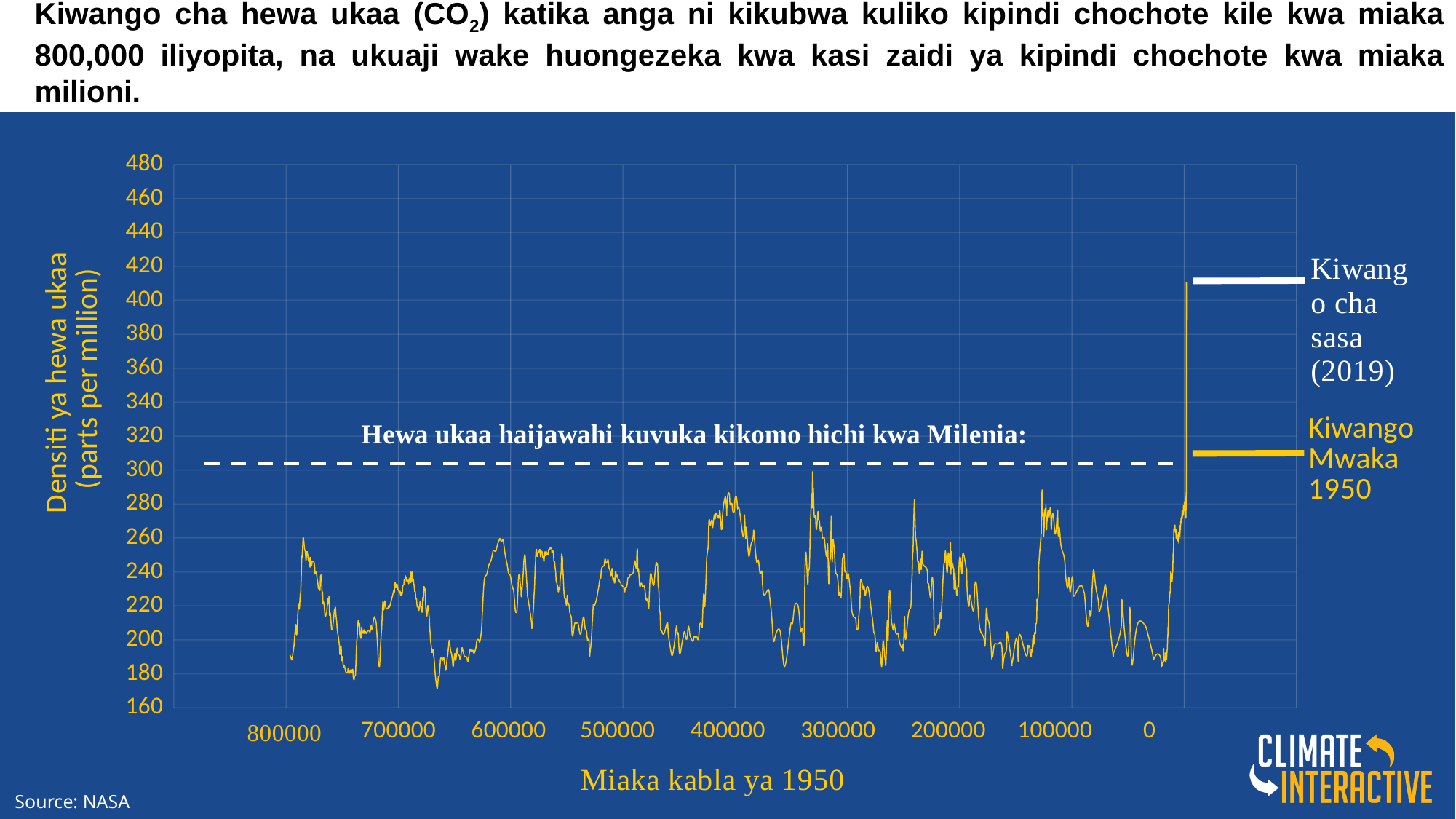
How many tick labels are shown on the x axis? 9 Is the current (2019) level marked by the white line greater or less than 400? greater What kind of chart is shown on the slide? line chart Is the lowest value reached by the line greater or less than 180? less What is the label of the x axis of the chart? Miaka kabla ya 1950 Is the 1950 level marked by the yellow line (Kiwango Mwaka 1950) greater or less than 340? less What is the label of the y axis of the chart? Densiti ya hewa ukaa (parts per million) What is the highest tick value shown on the y axis? 480 Does the line rise or fall sharply at the far right end of the x axis? rise